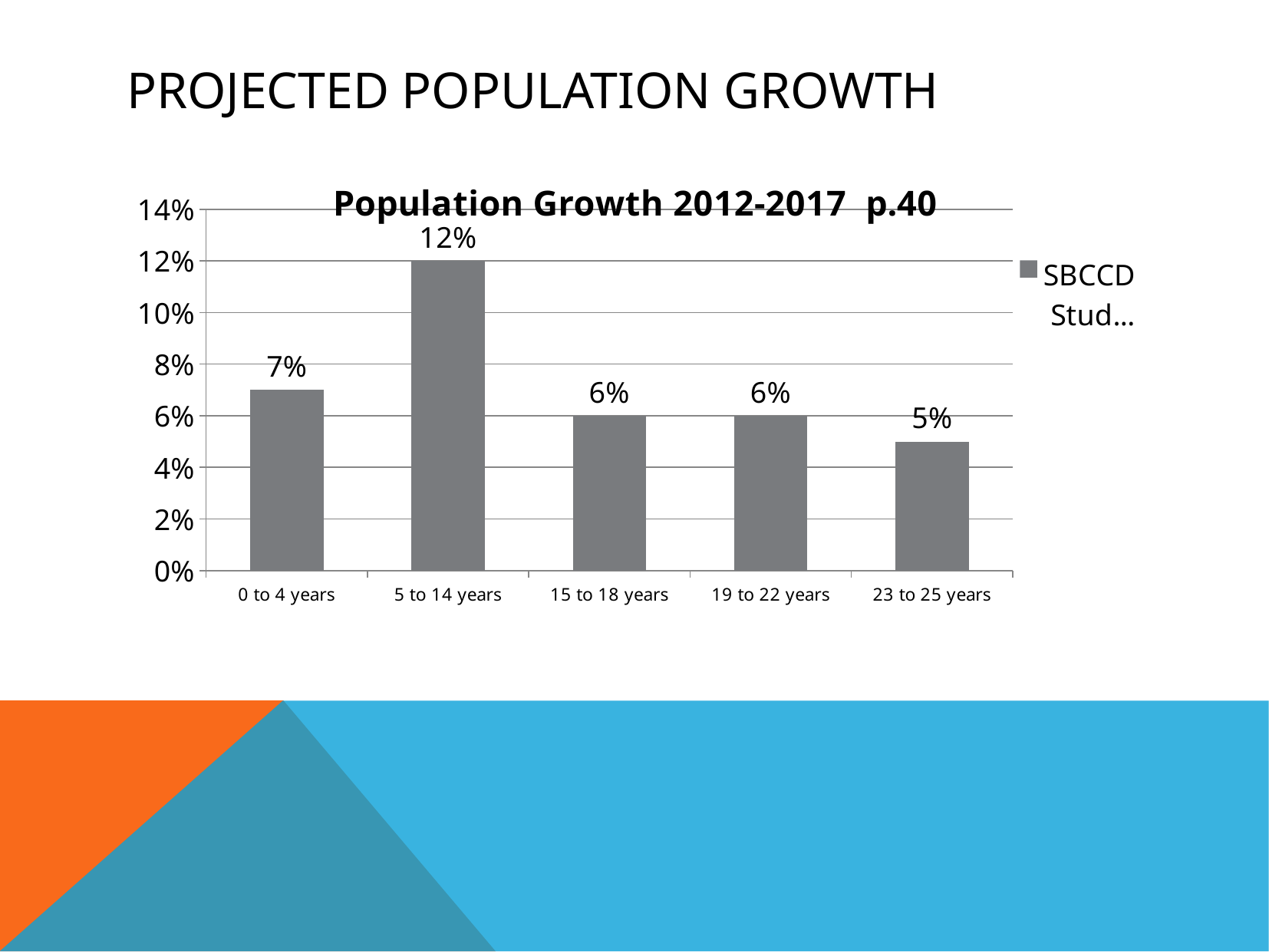
Is the value for 5 to 14 years greater or less than 10%? greater What is the value for 19 to 22 years? 6% What is the value for 0 to 4 years? 7% Which age group has the lowest projected population growth? 23 to 25 years What is the title of the chart? Population Growth 2012-2017 p.40 What is the value for 5 to 14 years? 12% Which age group has the highest projected population growth? 5 to 14 years Which is larger, the value for 0 to 4 years or the value for 15 to 18 years? 0 to 4 years What is the difference between the values for 5 to 14 years and 0 to 4 years? 5% What is the value for 23 to 25 years? 5% How many age groups are shown on the chart? 5 What kind of chart is shown on the slide? bar chart